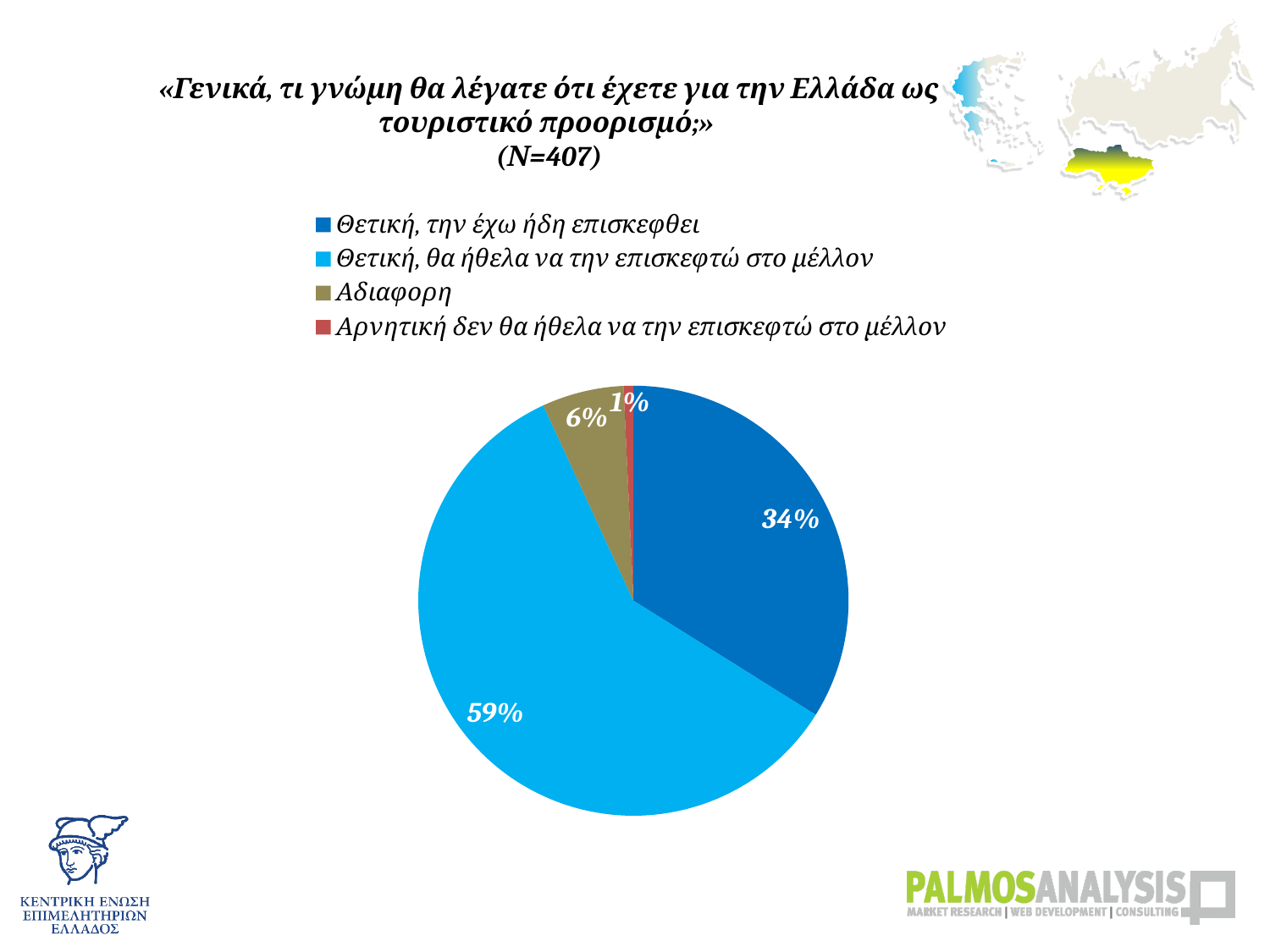
What share of respondents answered "Θετική, θα ήθελα να την επισκεφτώ στο μέλλον"? 59% What is the sample size (N) stated in the chart title? N=407 What kind of chart is shown on the slide? pie chart What share of respondents answered "Αρνητική δεν θα ήθελα να την επισκεφτώ στο μέλλον"? 1% Which response has the smallest share of the pie? Αρνητική δεν θα ήθελα να την επισκεφτώ στο μέλλον Which is larger: the share for "Αδιαφορη" or the share for "Αρνητική δεν θα ήθελα να την επισκεφτώ στο μέλλον"? Αδιαφορη What share of respondents answered "Θετική, την έχω ήδη επισκεφθει"? 34% What is the difference in percentage points between "Θετική, θα ήθελα να την επισκεφτώ στο μέλλον" and "Θετική, την έχω ήδη επισκεφθει"? 25 percentage points How many slices does the pie chart have? 4 What share of respondents answered "Αδιαφορη"? 6% Which response has the largest share of the pie? Θετική, θα ήθελα να την επισκεφτώ στο μέλλον How many entries does the legend list? 4